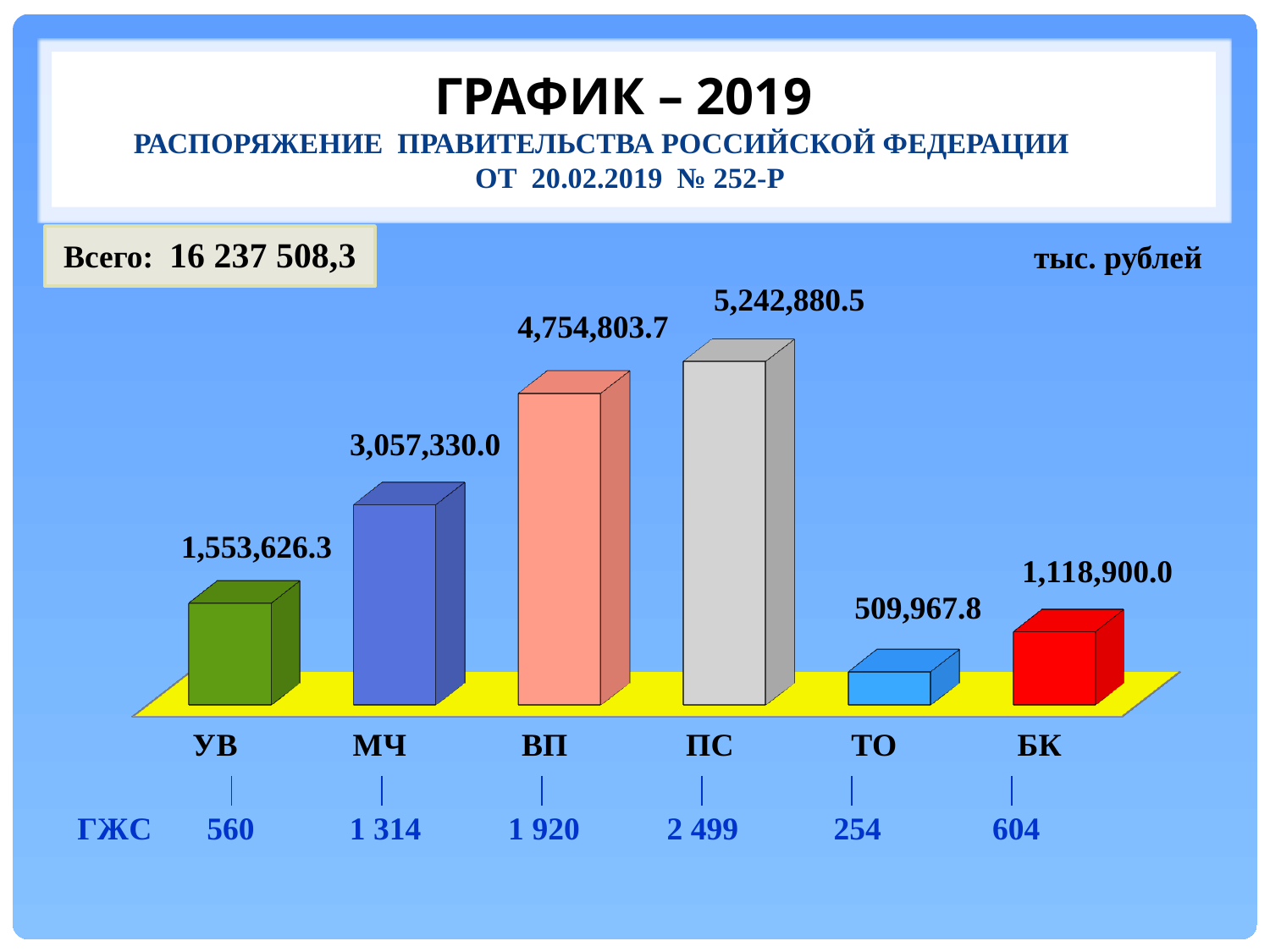
What is the ГЖС number shown under ПС? 2 499 What unit is stated for the chart values? тыс. рублей Which is larger, the value for УВ or the value for БК? УВ What is the value shown for МЧ? 3,057,330.0 Which category has the highest value? ПС What is the value shown for ВП? 4,754,803.7 What is the difference between the values for ПС and ВП? 488,076.8 What is the value shown for ТО? 509,967.8 Which category has the lowest value? ТО How many categories are shown in the chart? 6 What kind of chart is shown on the slide? bar chart What is the difference between the values for УВ and БК? 434,726.3